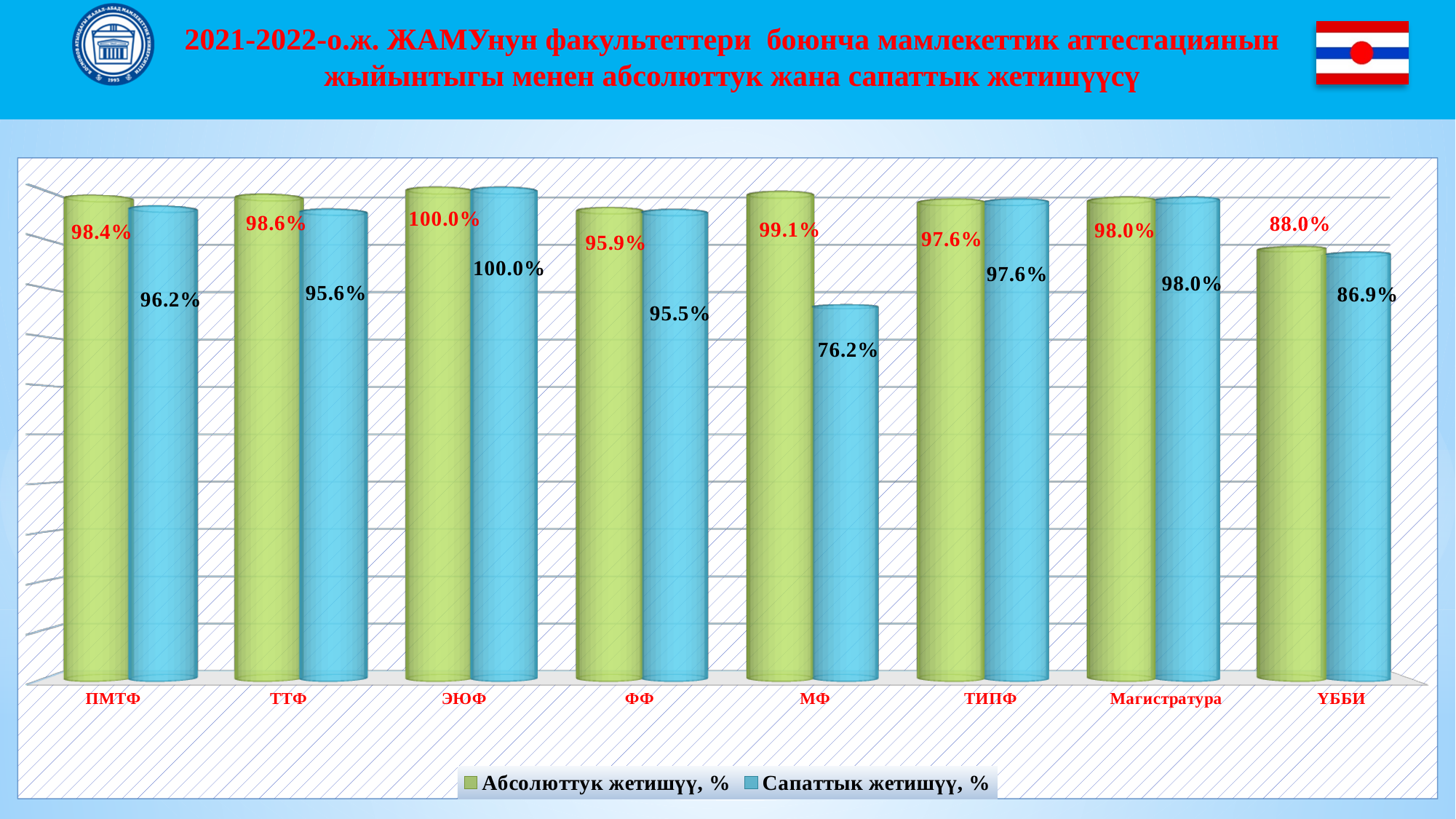
How many series does the legend list? 2 What colour are the bars for Сапаттык жетишүү, %? Blue What kind of chart is shown on the slide? Bar chart What is the value of Сапаттык жетишүү, % for ҮББИ? 86.9% Which category has the lowest value for Сапаттык жетишүү, %? МФ Which is larger for ТТФ: Абсолюттук жетишүү, % or Сапаттык жетишүү, %? Абсолюттук жетишүү, % Which category has the lowest value for Абсолюттук жетишүү, %? ҮББИ What is the difference between Абсолюттук жетишүү, % and Сапаттык жетишүү, % for МФ? 22.9% What is the value of Абсолюттук жетишүү, % for МФ? 99.1% Which category has the highest value for Абсолюттук жетишүү, %? ЭЮФ What is the value of Сапаттык жетишүү, % for ПМТФ? 96.2% How many categories are shown on the x axis? 8